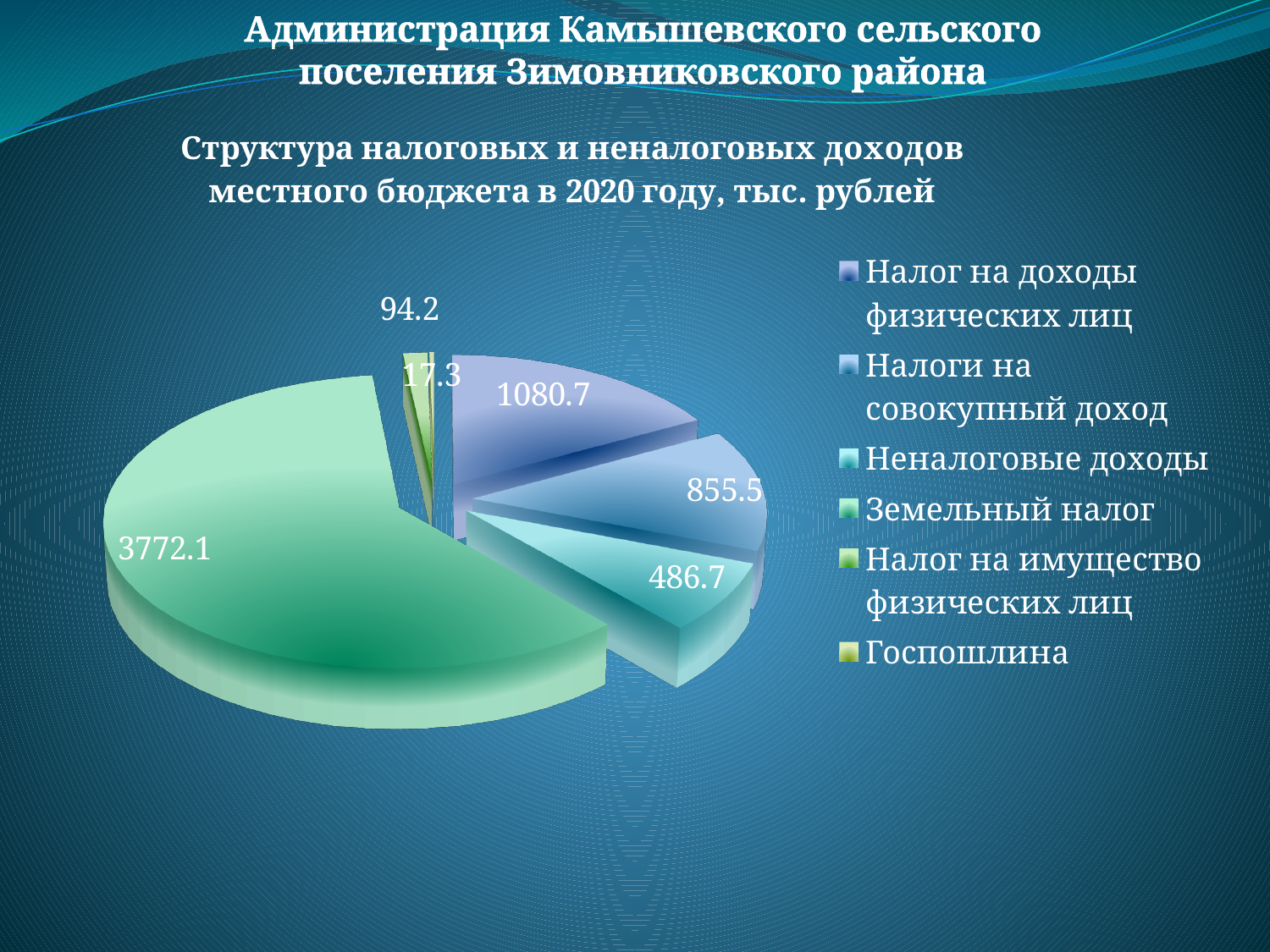
What kind of chart is shown on the slide? Pie chart What is the value for Земельный налог? 3772.1 What is the difference between Налог на доходы физических лиц and Налоги на совокупный доход? 225.2 Which is larger: Налоги на совокупный доход or Неналоговые доходы? Налоги на совокупный доход How many categories does the pie chart have? 6 What is the value for Неналоговые доходы? 486.7 What is the difference between Налог на имущество физических лиц and Госпошлина? 76.9 Which category has the smallest slice of the pie? Госпошлина What is the value for Налог на доходы физических лиц? 1080.7 Which category has the largest slice of the pie? Земельный налог What year does the chart title say the budget revenue structure refers to? 2020 What is the value for Госпошлина? 17.3